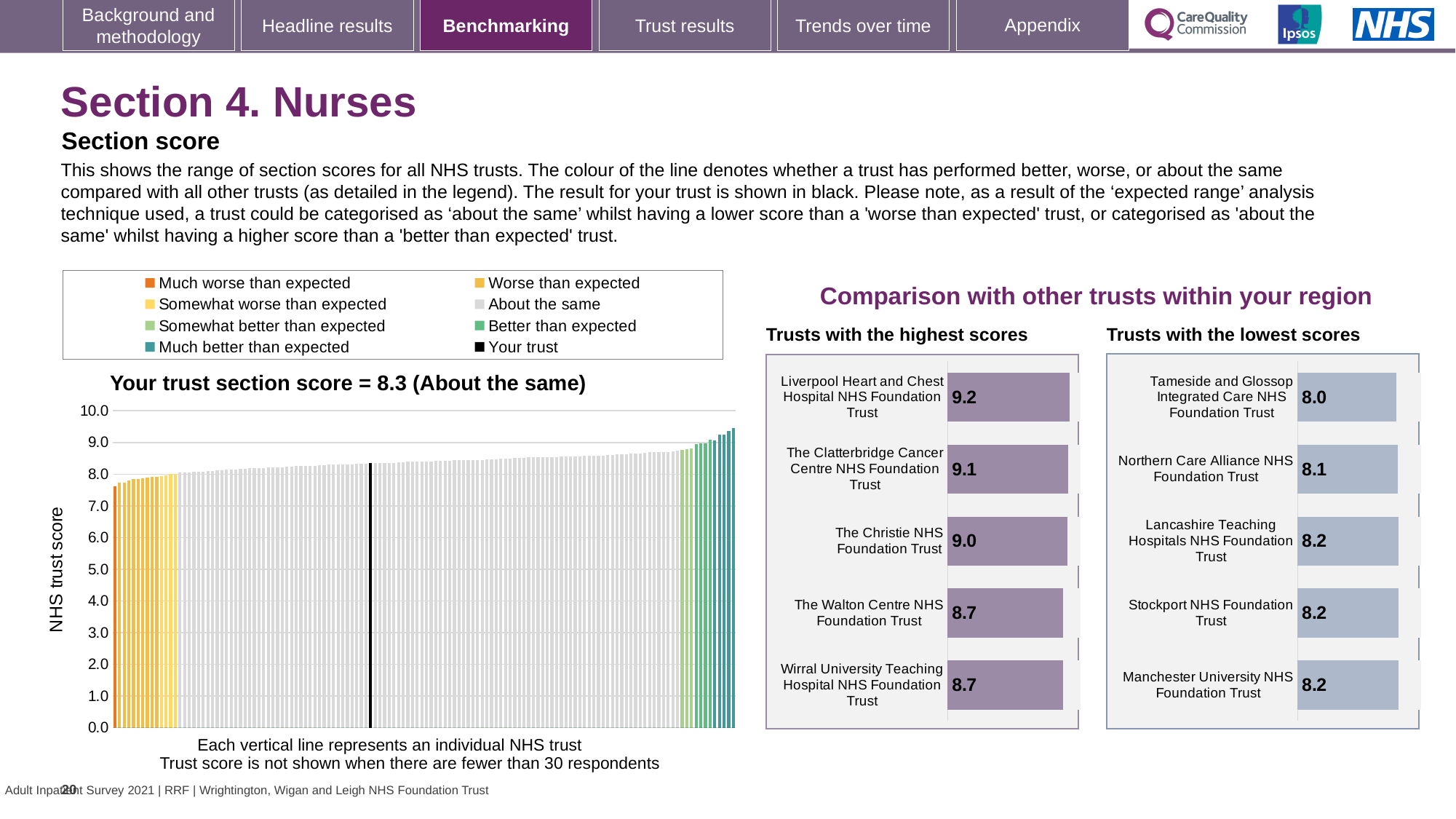
In the 'Trusts with the highest scores' chart, what is the score for The Christie NHS Foundation Trust? 9.0 In the 'Trusts with the highest scores' chart, what is the difference between the scores of Liverpool Heart and Chest Hospital NHS Foundation Trust and The Walton Centre NHS Foundation Trust? 0.5 In the 'Trusts with the lowest scores' chart, what is the difference between the scores of Stockport NHS Foundation Trust and Tameside and Glossop Integrated Care NHS Foundation Trust? 0.2 In the 'Trusts with the highest scores' chart, which trust has the highest score? Liverpool Heart and Chest Hospital NHS Foundation Trust In the main section score chart on the left, is the value of the highest bar greater or less than 9.0? greater In the 'Trusts with the lowest scores' chart, which has the larger score: Northern Care Alliance NHS Foundation Trust or Tameside and Glossop Integrated Care NHS Foundation Trust? Northern Care Alliance NHS Foundation Trust In the main section score chart on the left, what is the section score for your trust? 8.3 In the 'Trusts with the highest scores' chart, what is the score for Liverpool Heart and Chest Hospital NHS Foundation Trust? 9.2 In the main section score chart on the left, how many entries does the legend list? 8 In the 'Trusts with the lowest scores' chart, which trust has the lowest score? Tameside and Glossop Integrated Care NHS Foundation Trust In the 'Trusts with the highest scores' chart, how many trusts are listed? 5 In the 'Trusts with the lowest scores' chart, what is the score for Northern Care Alliance NHS Foundation Trust? 8.1